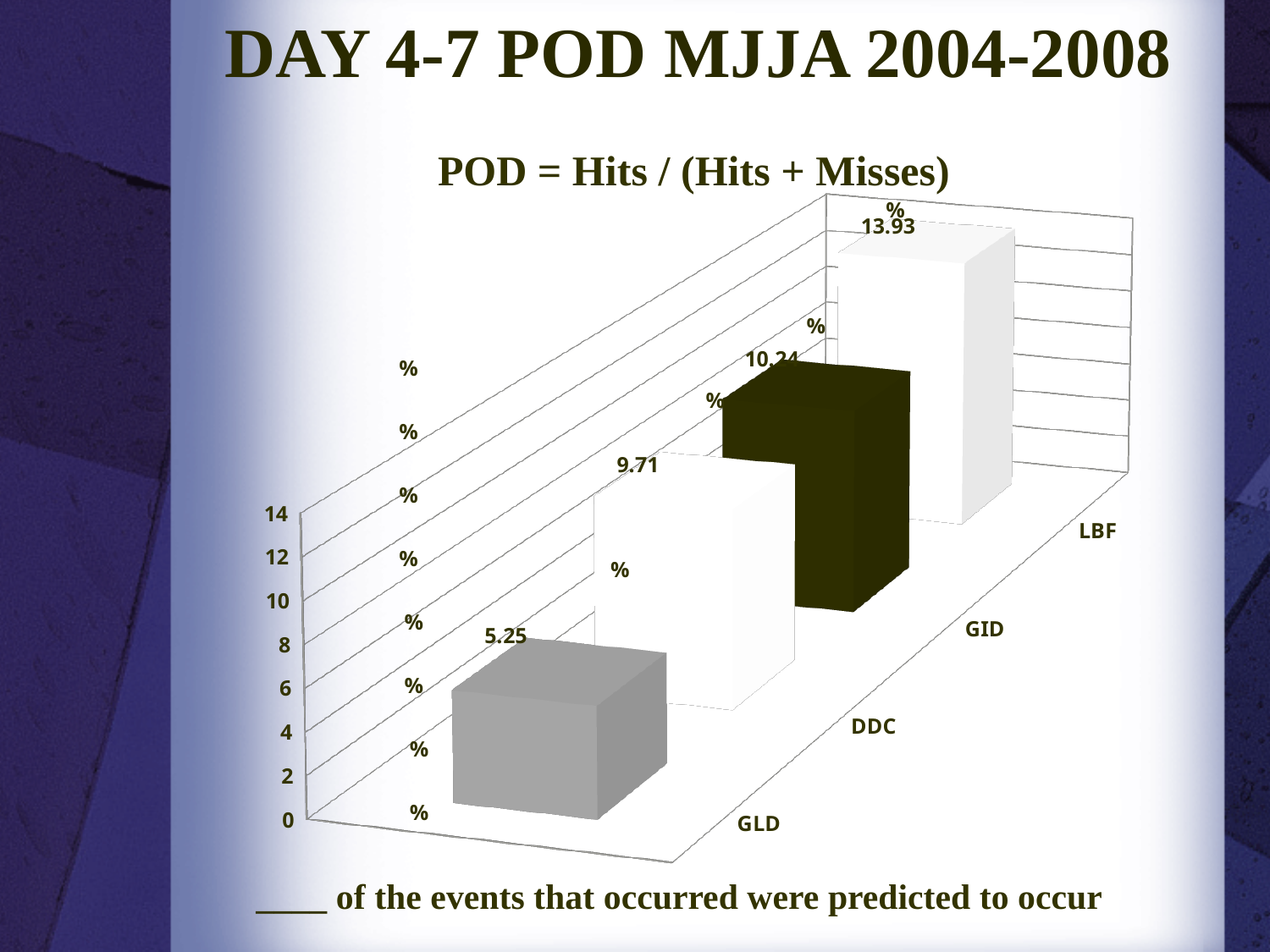
What is the POD value for LBF? 13.93% What kind of chart is shown on the slide? Bar chart What is the POD value for DDC? 9.71% Which has a larger POD value, GID or DDC? GID What is the difference between the POD values for LBF and GLD? 8.68 How many categories are shown in the chart? 4 What is the POD value for GLD? 5.25% Which category has the highest POD value? LBF What is the title of the chart? POD = Hits / (Hits + Misses) What is the difference between the POD values for GID and DDC? 0.53 Which category has the lowest POD value? GLD What is the POD value for GID? 10.24%